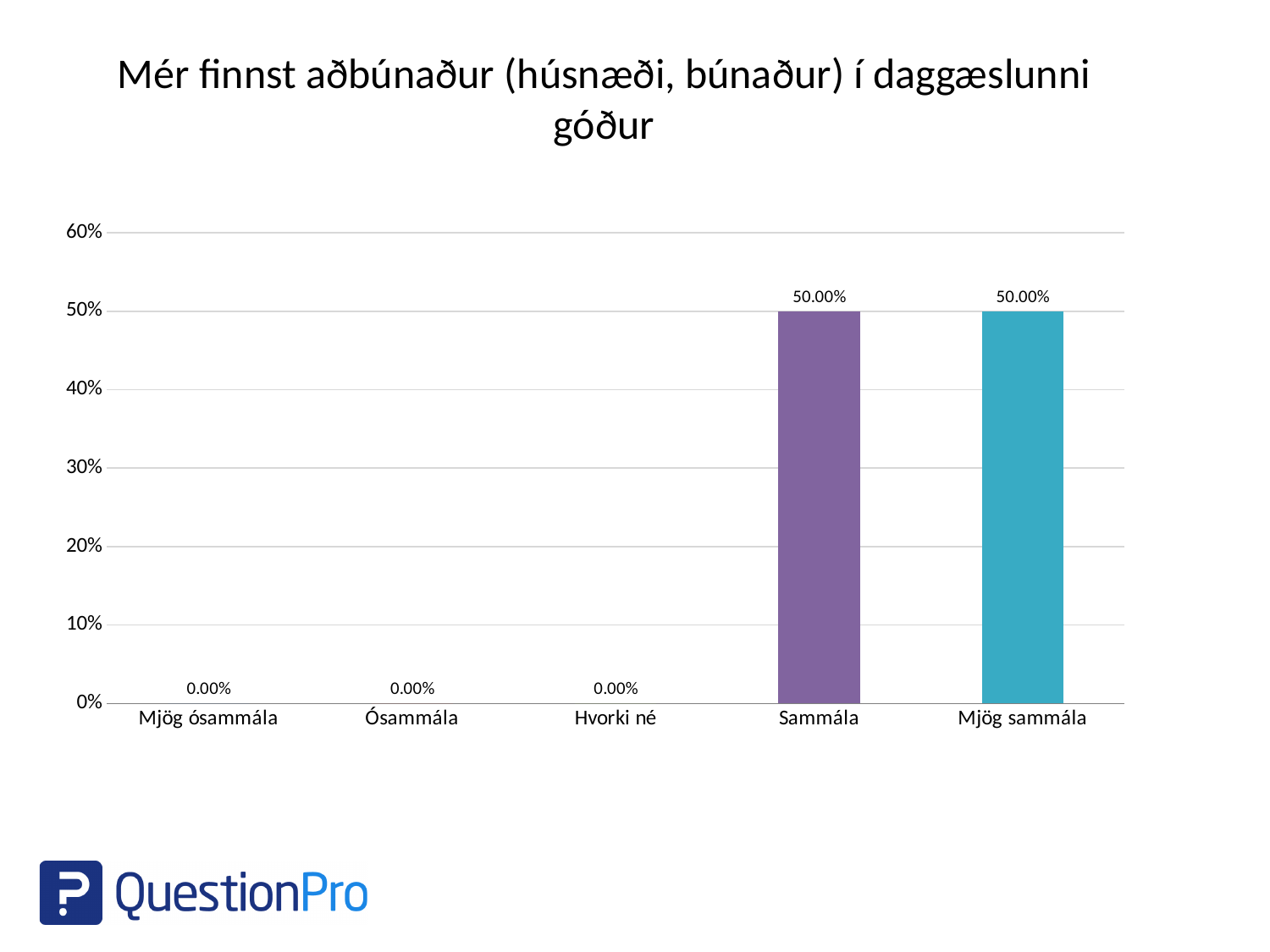
What is the highest value shown on the y axis? 60% What is the title of the chart? Mér finnst aðbúnaður (húsnæði, búnaður) í daggæslunni góður What is the value for Ósammála? 0.00% What kind of chart is shown on the slide? bar chart What is the value for Mjög sammála? 50.00% What is the value for Sammála? 50.00% How many categories are shown on the x axis? 5 Is the value for Sammála greater or less than 40%? greater What is the difference between the values for Sammála and Hvorki né? 50.00% What is the value for Hvorki né? 0.00% Which is larger, the value for Mjög sammála or the value for Ósammála? Mjög sammála What is the value for Mjög ósammála? 0.00%